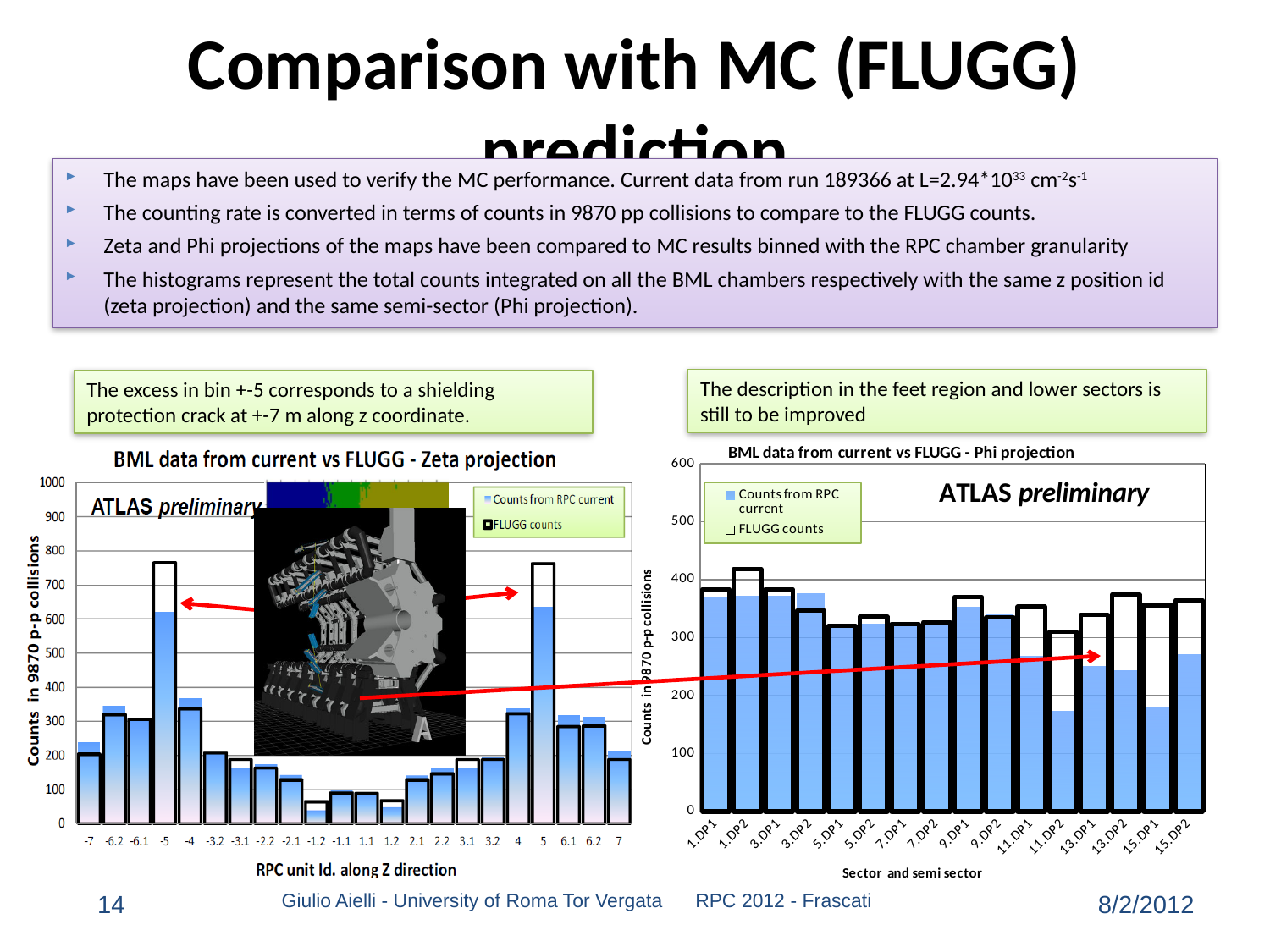
In the 'BML data from current vs FLUGG - Phi projection' chart, is the Counts from RPC current value for 11.DP2 greater or less than 200? less How many categories are shown on the x axis of the 'BML data from current vs FLUGG - Phi projection' chart? 16 In the 'BML data from current vs FLUGG - Zeta projection' chart, is the FLUGG counts value for -1.2 greater or less than 100? less What kind of chart is the 'BML data from current vs FLUGG - Zeta projection' chart? bar chart How many categories are shown on the x axis of the 'BML data from current vs FLUGG - Zeta projection' chart? 22 In the 'BML data from current vs FLUGG - Phi projection' chart, is the Counts from RPC current value for 13.DP2 greater or less than 300? less In the 'BML data from current vs FLUGG - Phi projection' chart, which category has the highest FLUGG counts value? 1.DP2 How many series does the legend list in the 'BML data from current vs FLUGG - Phi projection' chart? 2 What is the x-axis title of the 'BML data from current vs FLUGG - Phi projection' chart? Sector and semi sector In the 'BML data from current vs FLUGG - Phi projection' chart, which is larger: the FLUGG counts value for 1.DP2 or for 11.DP2? 1.DP2